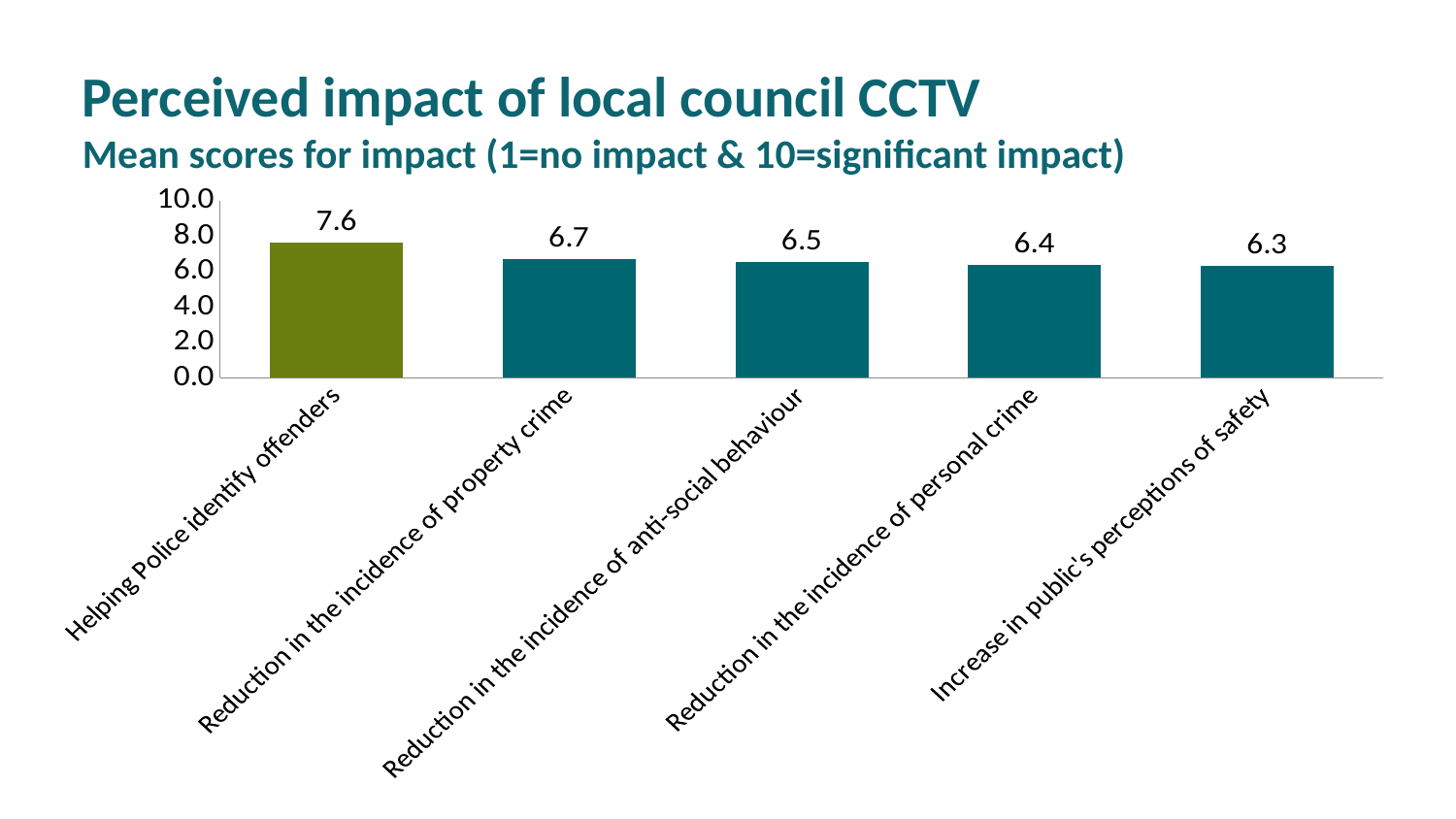
What kind of chart is shown on the slide? Bar chart What is the difference between the mean scores for 'Helping Police identify offenders' and 'Reduction in the incidence of personal crime'? 1.2 Which category has the lowest mean impact score? Increase in public's perceptions of safety What is the mean impact score for 'Helping Police identify offenders'? 7.6 Which has a higher mean score: 'Reduction in the incidence of property crime' or 'Reduction in the incidence of personal crime'? Reduction in the incidence of property crime What is the mean impact score for 'Reduction in the incidence of anti-social behaviour'? 6.5 Which category has the highest mean impact score? Helping Police identify offenders What is the mean impact score for 'Reduction in the incidence of property crime'? 6.7 Is the value for 'Reduction in the incidence of anti-social behaviour' greater or less than 6.0? greater How many categories are shown in the chart? 5 Which bar is shown in a different colour (green) from the others? Helping Police identify offenders What is the mean impact score for 'Increase in public's perceptions of safety'? 6.3